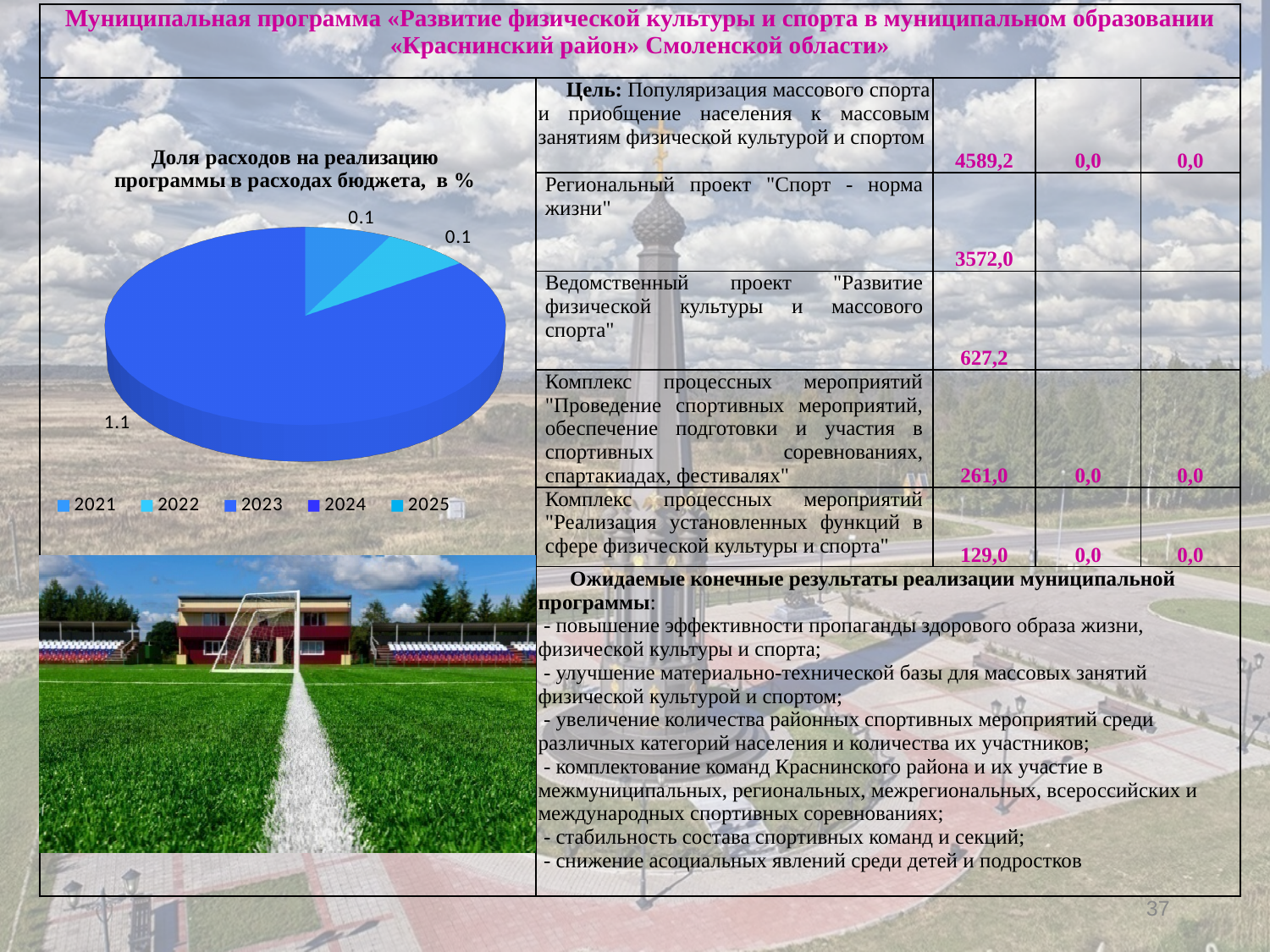
Is the largest labelled value on the pie chart greater or less than 1? greater How many data labels are shown on the pie chart? 3 How many entries does the legend of the pie chart list? 5 Is the largest slice of the pie chart larger or smaller than the two small slices combined? larger What is the title of the pie chart? Доля расходов на реализацию программы в расходах бюджета, в % Which years are listed in the legend of the pie chart? 2021, 2022, 2023, 2024, 2025 What is the largest value labelled on the pie chart? 1.1 What kind of chart is shown on the slide? pie chart What is the smallest value labelled on the pie chart? 0.1 What is the difference between the largest labelled value (1.1) and a smallest labelled value (0.1) on the pie chart? 1.0